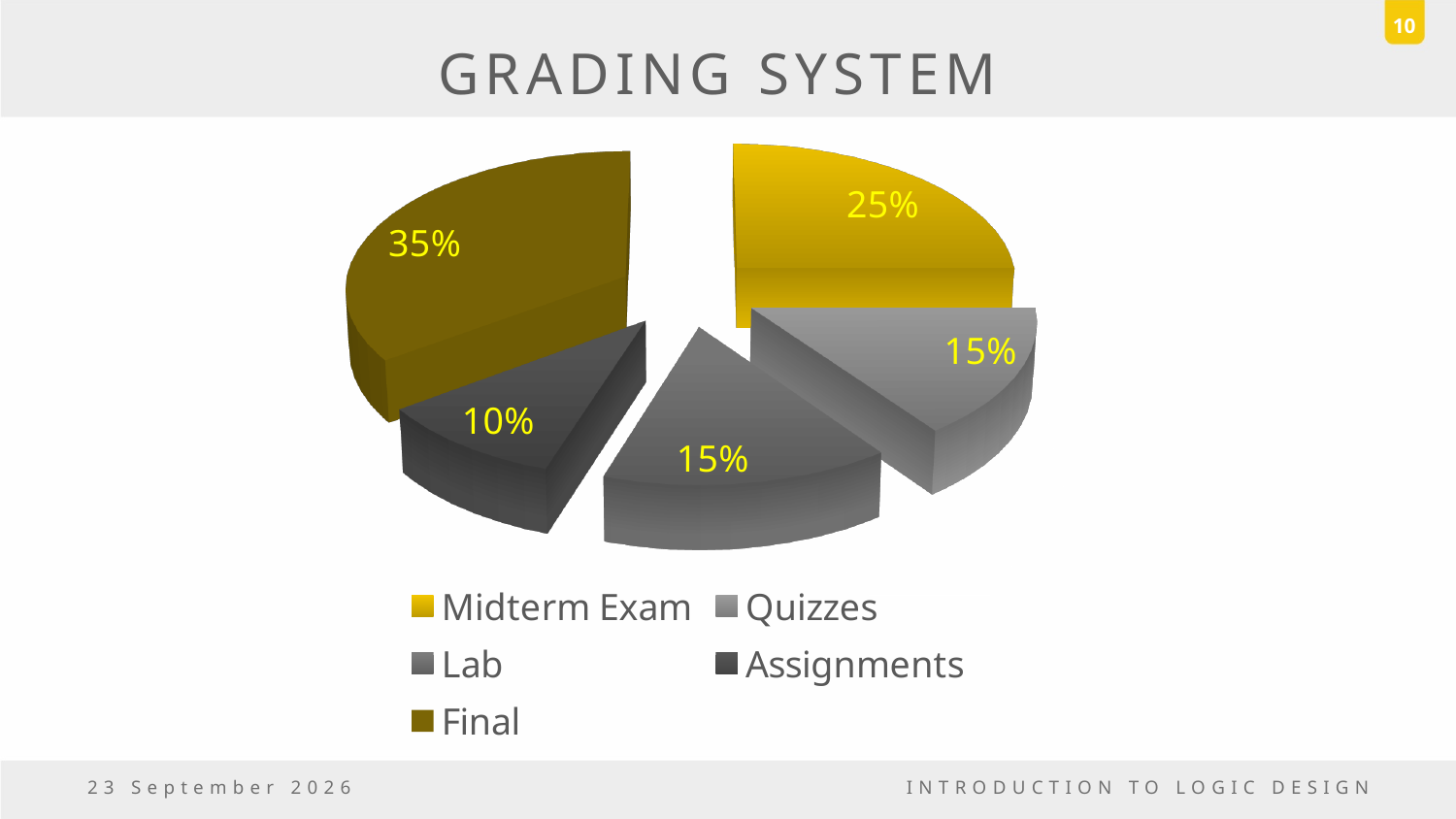
What percentage of the grade do Assignments account for? 10% What is the title of the chart? Grading System What percentage of the grade does the Midterm Exam account for? 25% Which is larger, the share for the Midterm Exam or the share for Lab? Midterm Exam Which component has the smallest share of the grade? Assignments How many percentage points larger is the Final than the Midterm Exam? 10 What kind of chart is shown on the slide? Pie chart What percentage of the grade do Quizzes account for? 15% Which component has the largest share of the grade? Final What percentage of the grade does the Final account for? 35% What is the combined share of Quizzes and Lab? 30% How many slices does the pie chart have? 5